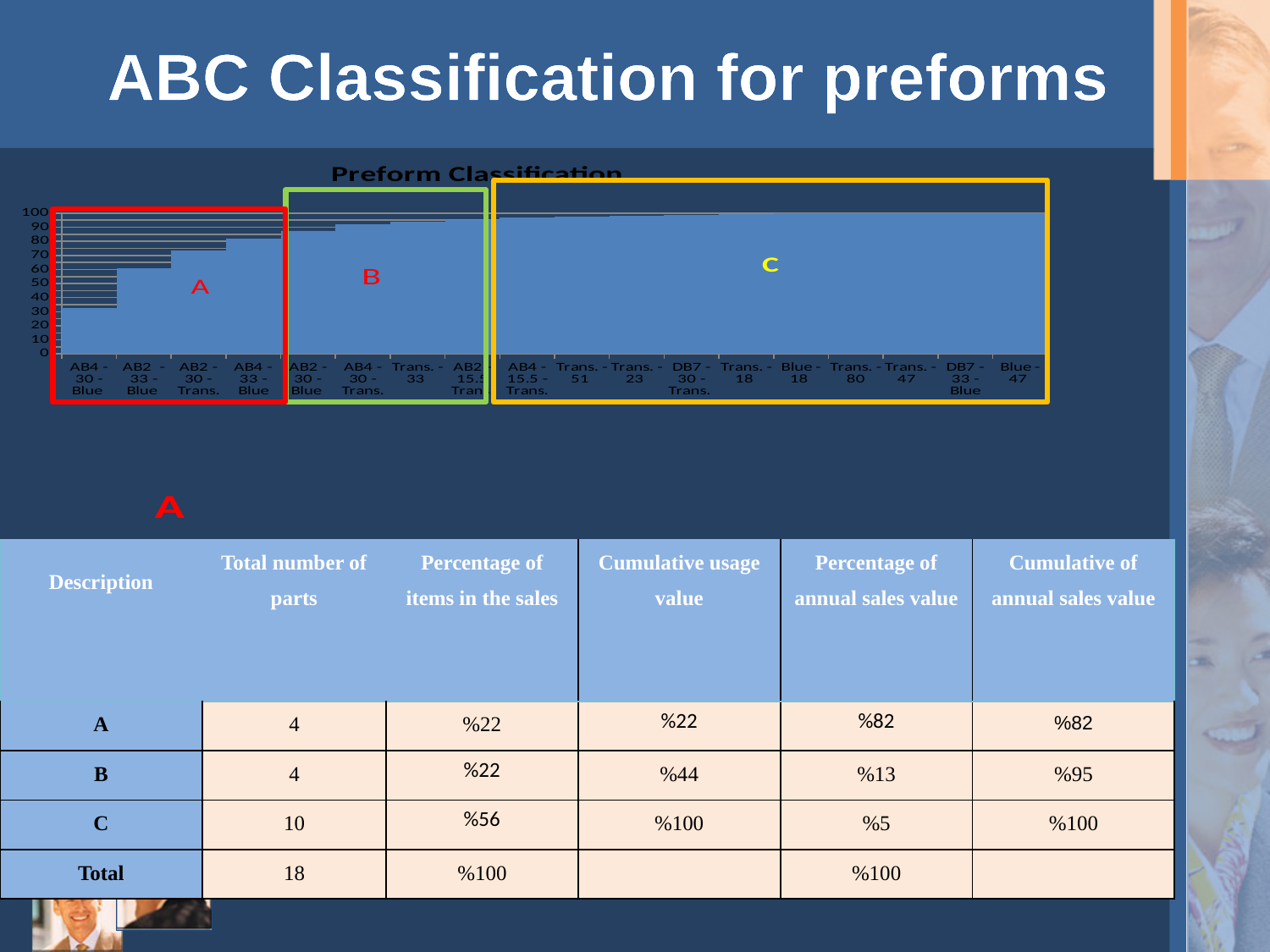
In the Preform Classification chart, is the value for AB2 - 30 - Trans. greater or less than 60? greater What kind of chart is the Preform Classification chart? bar chart What is the title of the chart on the slide? Preform Classification In the Preform Classification chart, which is larger, the value for AB4 - 30 - Blue or the value for AB2 - 33 - Blue? AB2 - 33 - Blue In the Preform Classification chart, is the value for AB4 - 30 - Blue greater or less than 50? less What is the highest value shown on the y axis of the Preform Classification chart? 100 In the Preform Classification chart, is the value for AB4 - 30 - Blue greater or less than 20? greater How many categories are plotted along the x axis of the Preform Classification chart? 18 Which category has the lowest value in the Preform Classification chart? AB4 - 30 - Blue Do the values in the Preform Classification chart rise or fall from left to right along the x axis? rise